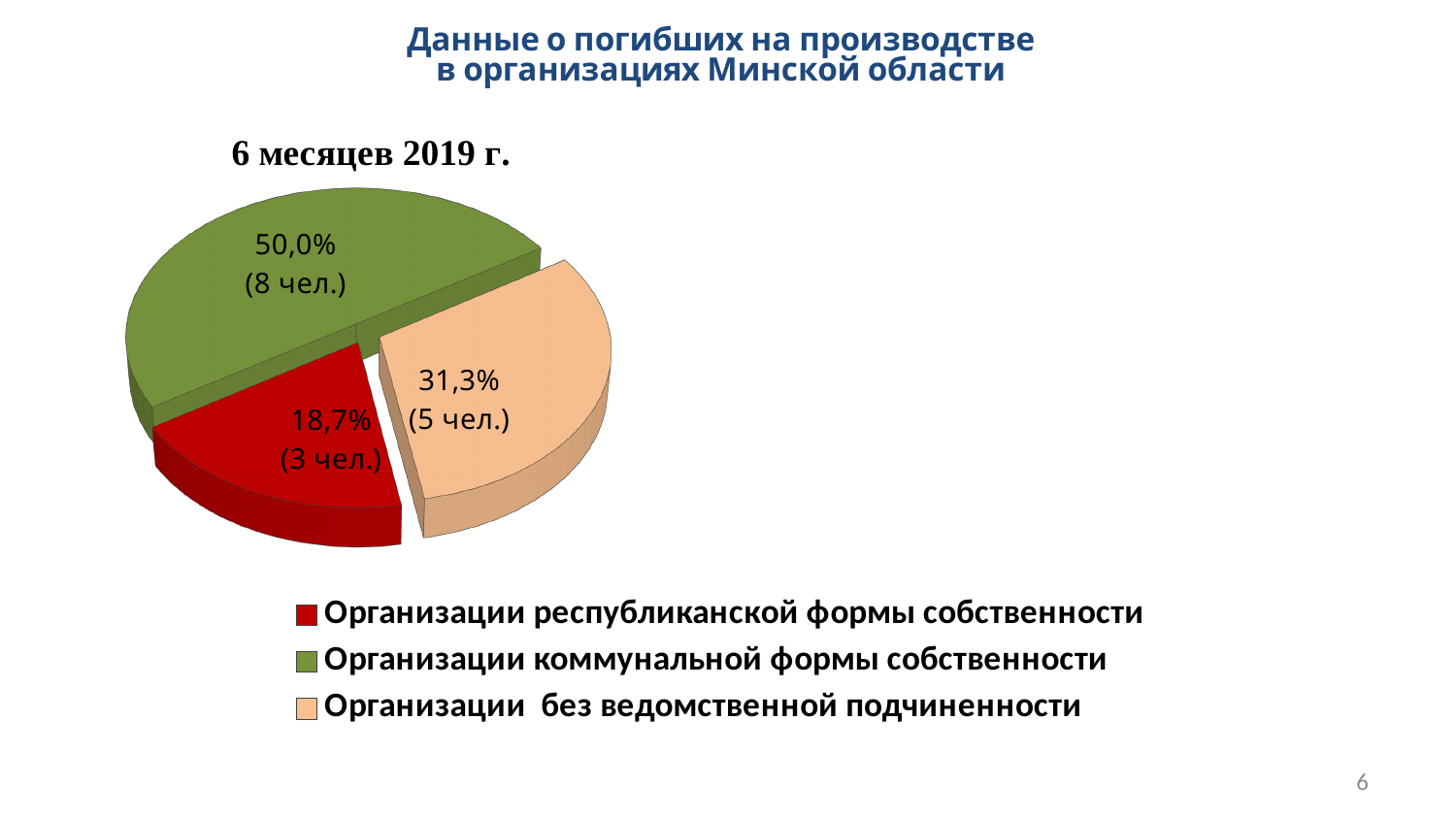
На сколько человек больше погибло в организациях без ведомственной подчиненности, чем в организациях республиканской формы собственности? 2 Сколько всего погибших показано на диаграмме (сумма по всем секторам)? 16 Какая доля погибших приходится на организации без ведомственной подчиненности? 31,3% Какой тип диаграммы показан на слайде? круговая диаграмма За какой период приведены данные на диаграмме? 6 месяцев 2019 г. Сколько категорий (секторов) показано на круговой диаграмме? 3 Какая категория организаций имеет наименьшую долю погибших? Организации республиканской формы собственности Какая доля погибших приходится на организации коммунальной формы собственности? 50,0% Сколько человек погибло в организациях республиканской формы собственности? 3 чел. Какая категория организаций имеет наибольшую долю погибших? Организации коммунальной формы собственности Сколько человек погибло в организациях коммунальной формы собственности? 8 чел. Где погибших больше: в организациях коммунальной формы собственности или в организациях без ведомственной подчиненности? Организации коммунальной формы собственности